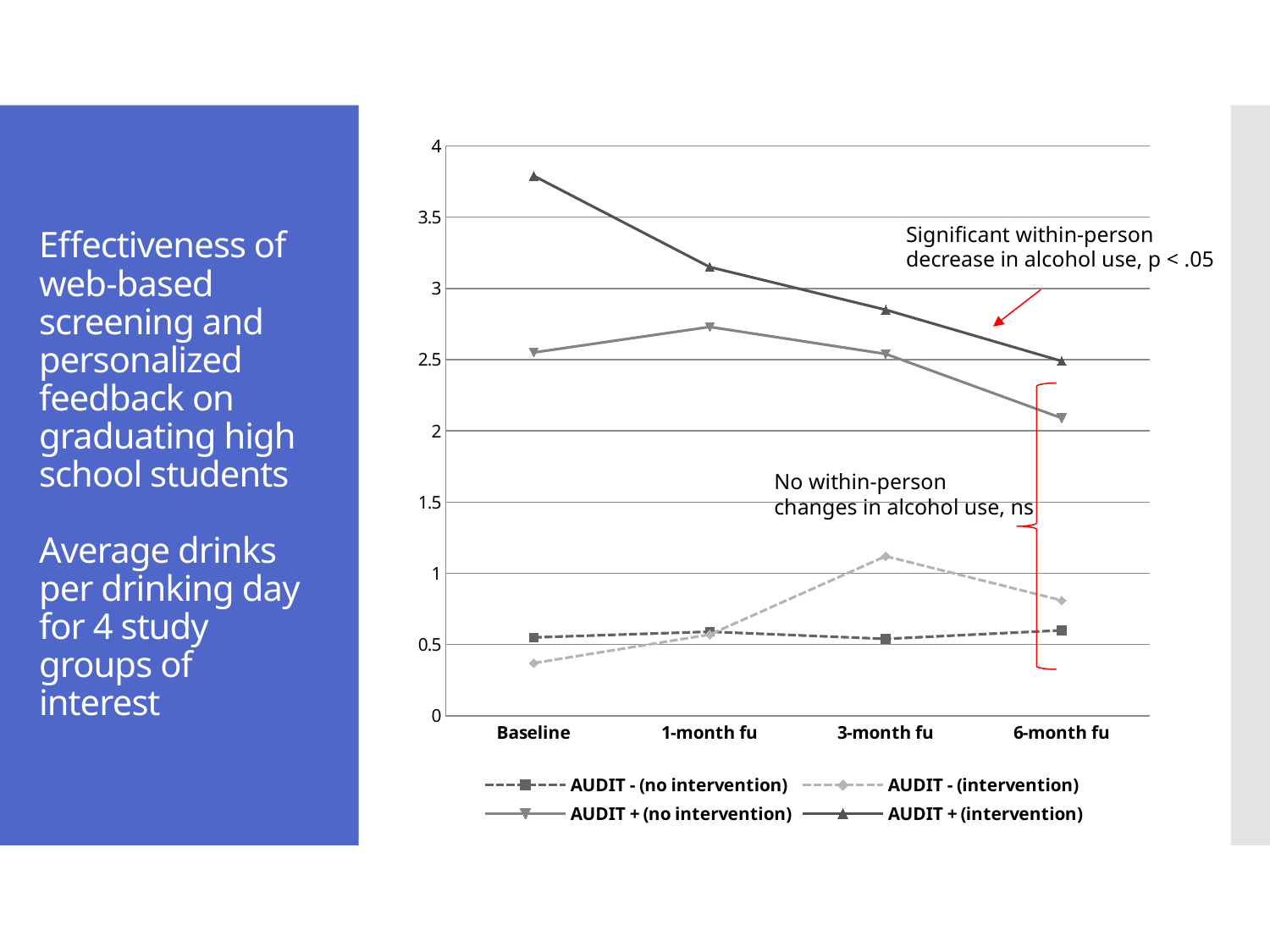
Is the value for AUDIT + (no intervention) at 6-month fu greater or less than 2.5? less Which series has the highest value at 3-month fu among the two AUDIT - series? AUDIT - (intervention) How many time points are shown on the x axis? 4 Is the value for AUDIT - (intervention) at 3-month fu greater or less than 1? greater How many series does the legend list? 4 At 1-month fu, which is larger: AUDIT + (intervention) or AUDIT + (no intervention)? AUDIT + (intervention) Is the value for AUDIT + (intervention) at Baseline greater or less than 3.5? greater Which series has the lowest value at Baseline? AUDIT - (intervention) What kind of chart is shown on the slide? line chart Which series has the highest value at Baseline? AUDIT + (intervention) Does the AUDIT + (intervention) series rise or fall from Baseline to 6-month fu? fall What is the label of the last time point on the x axis? 6-month fu